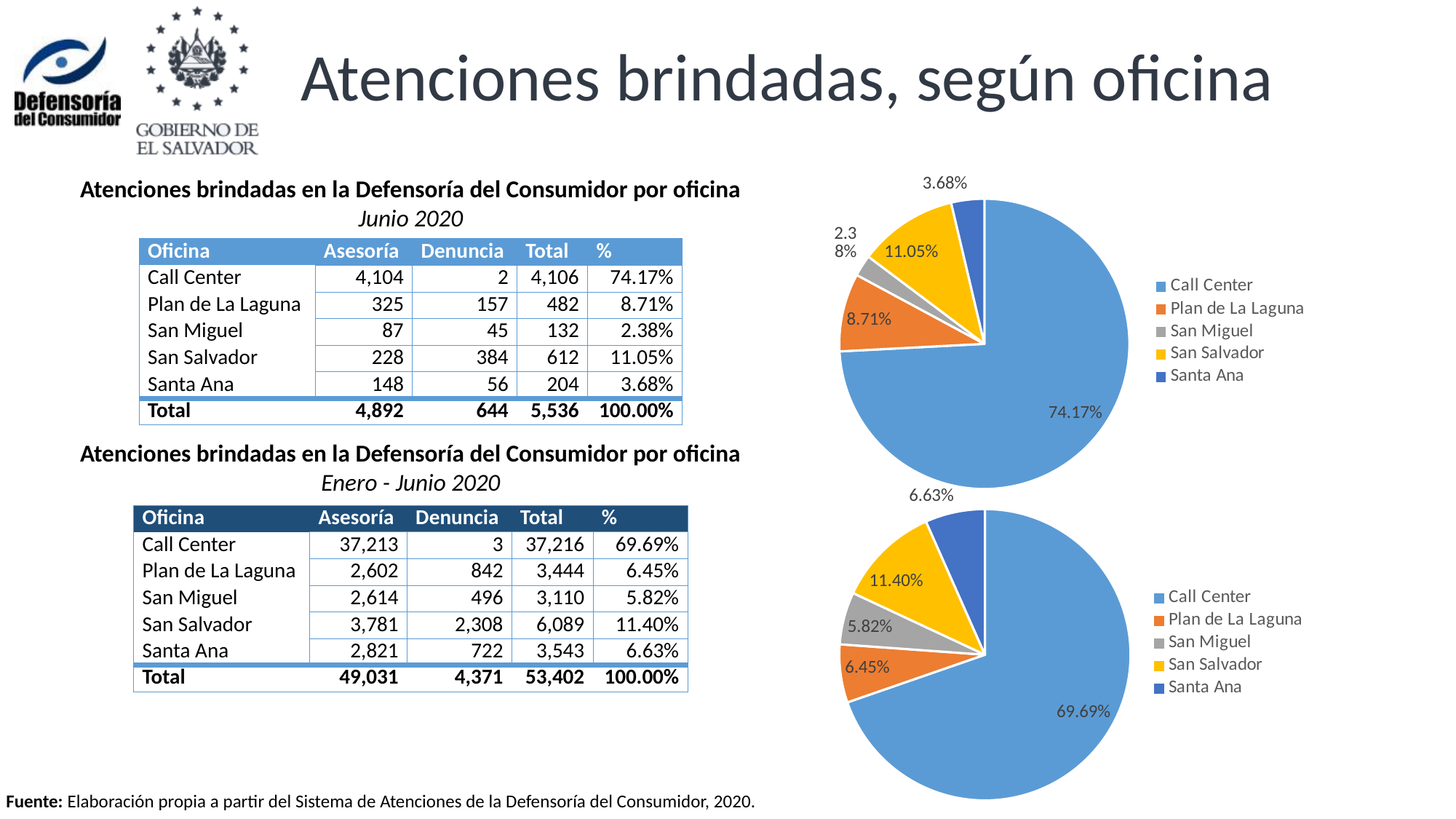
In the top pie chart, what share does Call Center have? 74.17% In the bottom pie chart, what is the difference between the San Salvador share and the Santa Ana share? 4.77% In the top pie chart, what share does San Salvador have? 11.05% In the top pie chart, which office has the largest slice? Call Center What kind of chart is the top chart on the right side of the slide? pie chart In the top pie chart, what share does Santa Ana have? 3.68% In the bottom pie chart, which is larger, the slice for Santa Ana or the slice for Plan de La Laguna? Santa Ana In the bottom pie chart, which office has the smallest slice? San Miguel In the top pie chart, which office has the smallest slice? San Miguel How many offices does the legend of the bottom pie chart list? 5